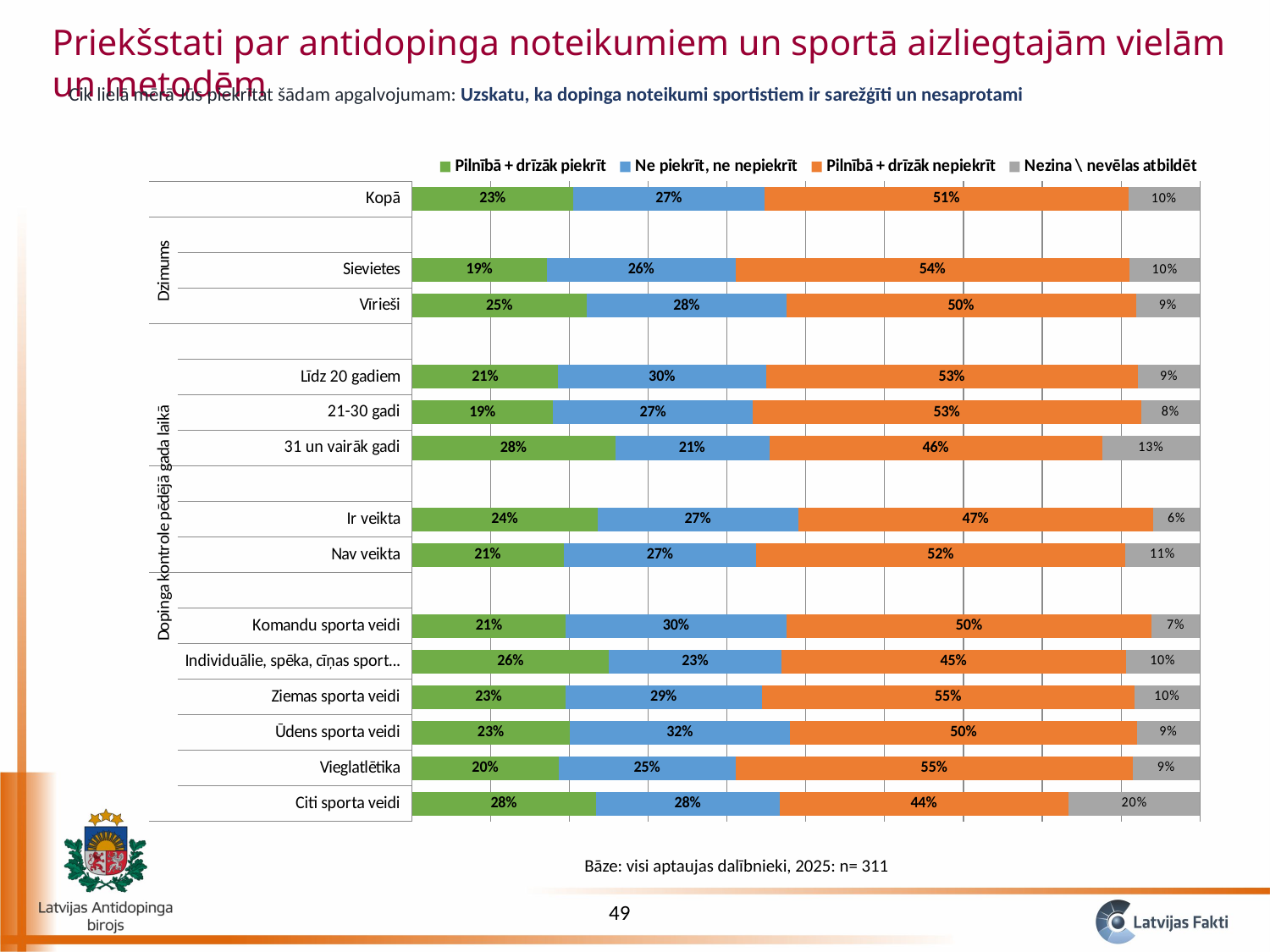
How many categories (bars) are plotted in the chart? 14 Which category has the lowest value for "Nezina \ nevēlas atbildēt"? Ir veikta What is the value of "Pilnībā + drīzāk piekrīt" for Sievietes? 19% What kind of chart is shown on the slide? Stacked bar chart What is the total of the stacked bar for Vieglatlētika? 109% What is the value of "Ne piekrīt, ne nepiekrīt" for Ūdens sporta veidi? 32% What is the value of "Nezina \ nevēlas atbildēt" for Citi sporta veidi? 20% How many series does the legend list? 4 What is the difference between the "Pilnībā + drīzāk nepiekrīt" values for Sievietes and Vīrieši? 4% What is the value of "Pilnībā + drīzāk nepiekrīt" for Kopā? 51% Which category has the highest value for "Nezina \ nevēlas atbildēt"? Citi sporta veidi Which is larger: the "Pilnībā + drīzāk piekrīt" value for 31 un vairāk gadi or for 21-30 gadi? 31 un vairāk gadi